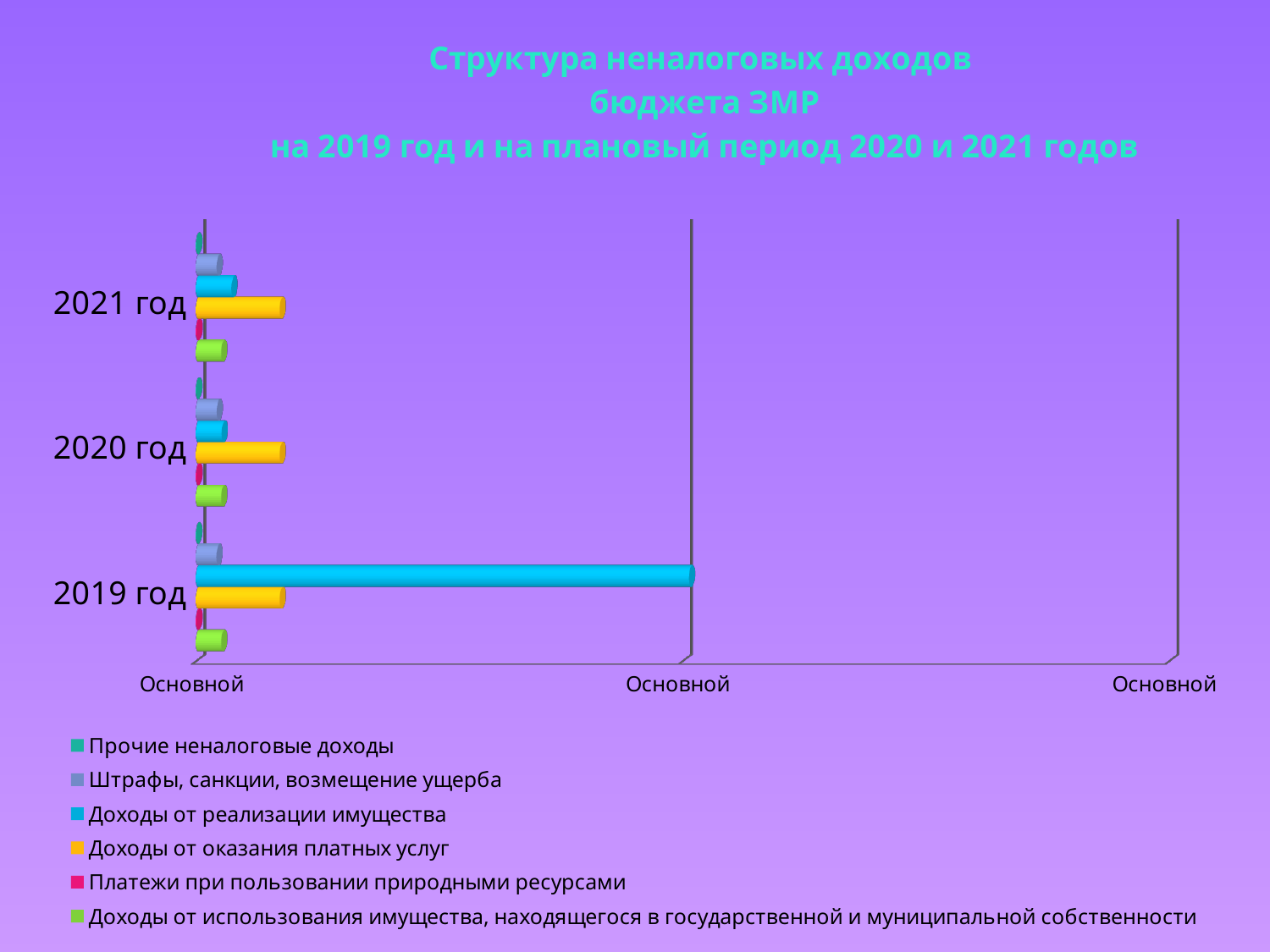
For 2021 год, which is larger: Доходы от оказания платных услуг or Штрафы, санкции, возмещение ущерба? Доходы от оказания платных услуг What colour represents the series Доходы от оказания платных услуг in the chart? Yellow How many year categories are shown on the vertical axis of the chart? 3 How many series does the chart legend list? 6 Which years are covered by the chart according to its title? 2019, 2020 and 2021 Which series has the longest bar for 2021 год? Доходы от оказания платных услуг What kind of chart is shown on the slide? Bar chart Which series has the longest bar for 2019 год? Доходы от реализации имущества In which year does the series Доходы от реализации имущества have its longest bar? 2019 год For 2019 год, which is larger: Доходы от реализации имущества or Доходы от оказания платных услуг? Доходы от реализации имущества